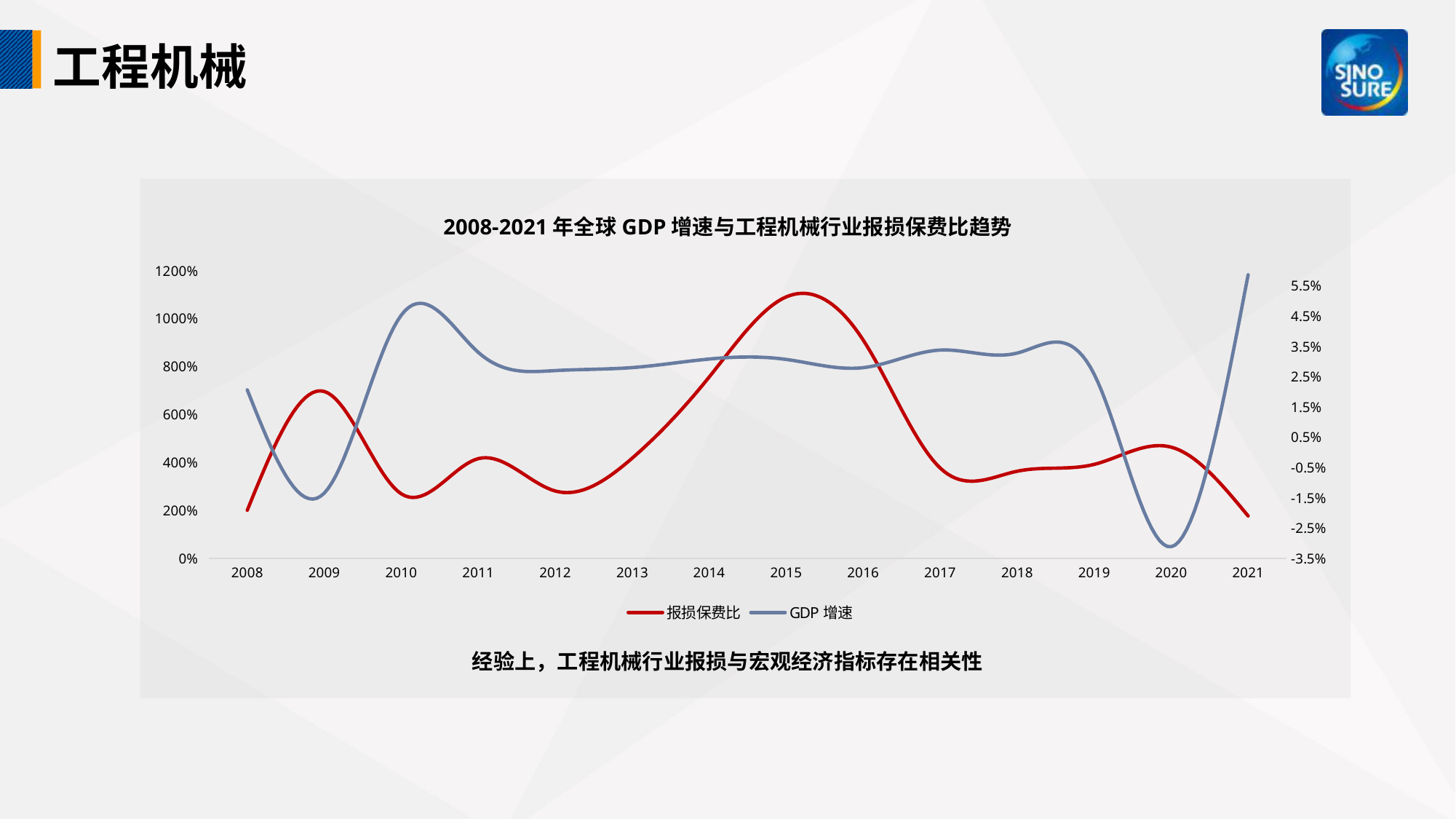
What kind of chart is shown on the slide? line chart Is the GDP 增速 value for 2020 greater or less than -2.5%? less How many series does the legend list? 2 What is the title of the chart? 2008-2021 年全球 GDP 增速与工程机械行业报损保费比趋势 In which year does the GDP 增速 series reach its lowest value? 2020 Does the 报损保费比 series rise or fall from 2015 to 2017? fall In which year does the GDP 增速 series reach its highest value? 2021 How many years are plotted along the x axis? 14 Which series is drawn in red? 报损保费比 In which year does the 报损保费比 series reach its highest value? 2015 Is the 报损保费比 value for 2015 greater or less than 1000%? greater Which year has the higher 报损保费比 value, 2009 or 2011? 2009